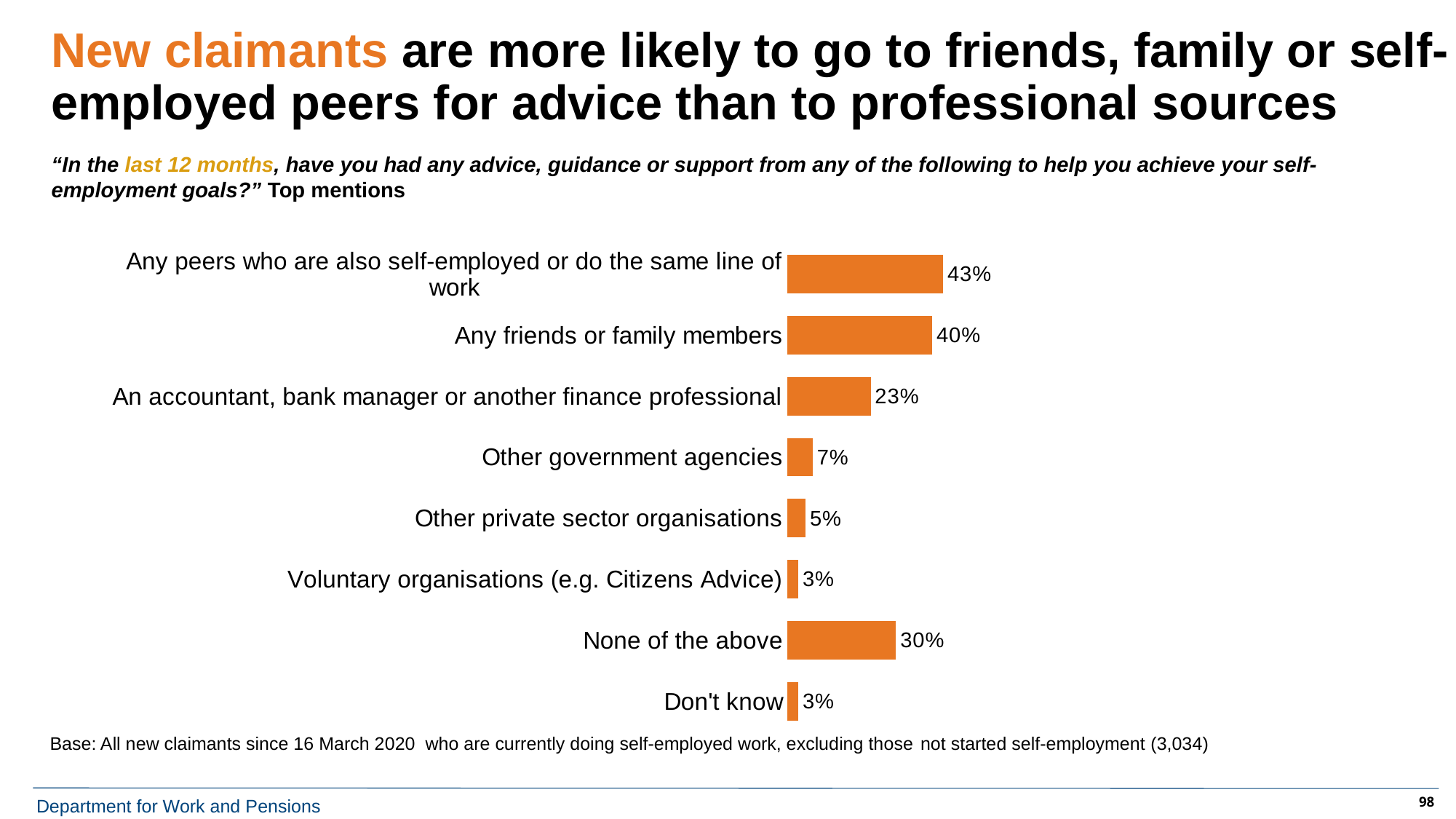
What kind of chart is shown on the slide? Bar chart What colour are the bars in the chart? Orange Which is larger: 'None of the above' or 'An accountant, bank manager or another finance professional'? None of the above What is the value for 'Other government agencies'? 7% What is the difference between the values for 'Any peers who are also self-employed or do the same line of work' and 'Any friends or family members'? 3% What is the difference between 'Other government agencies' and 'Other private sector organisations'? 2% What is the value for 'An accountant, bank manager or another finance professional'? 23% Which category has the highest value? Any peers who are also self-employed or do the same line of work What percentage of new claimants had advice from any friends or family members? 40% What percentage selected 'None of the above'? 30% How many categories are shown in the chart? 8 What is the value for 'Voluntary organisations (e.g. Citizens Advice)'? 3%